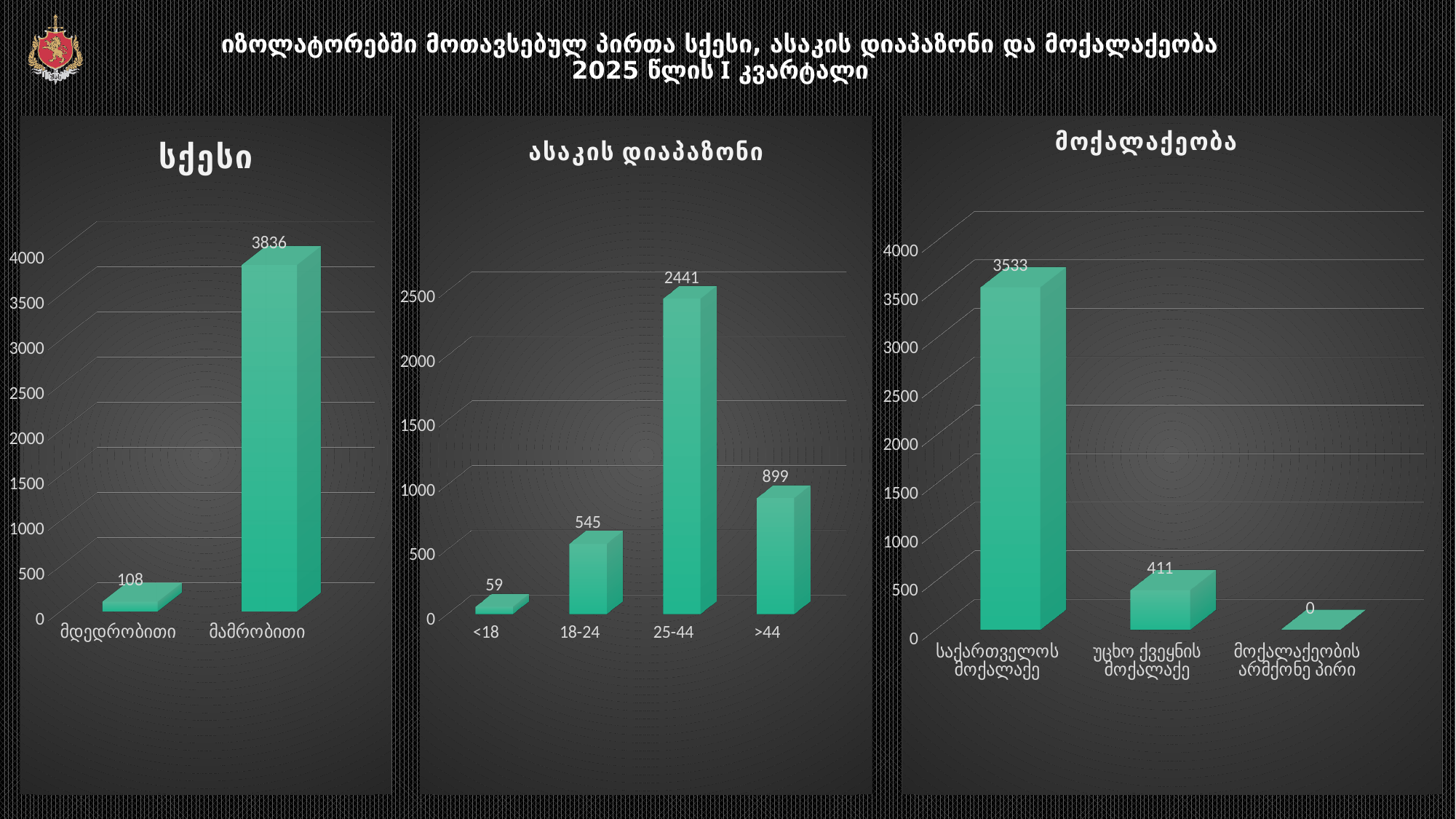
In the right chart (მოქალაქეობა), which category has the highest value? საქართველოს მოქალაქე What kind of chart is the left chart (სქესი)? bar chart In the middle chart (ასაკის დიაპაზონი), which is larger, the value for 18-24 or the value for >44? >44 In the right chart (მოქალაქეობა), what is the value for უცხო ქვეყნის მოქალაქე? 411 In the left chart (სქესი), what is the difference between the values for მამრობითი and მდედრობითი? 3728 In the middle chart (ასაკის დიაპაზონი), how many categories are shown? 4 In the middle chart (ასაკის დიაპაზონი), what is the difference between the values for >44 and 18-24? 354 In the middle chart (ასაკის დიაპაზონი), what is the value for the 25-44 category? 2441 In the middle chart (ასაკის დიაპაზონი), which category has the lowest value? <18 In the right chart (მოქალაქეობა), what is the value for მოქალაქეობის არმქონე პირი? 0 In the left chart (სქესი), what is the value for მდედრობითი? 108 In the left chart (სქესი), what is the value for მამრობითი? 3836